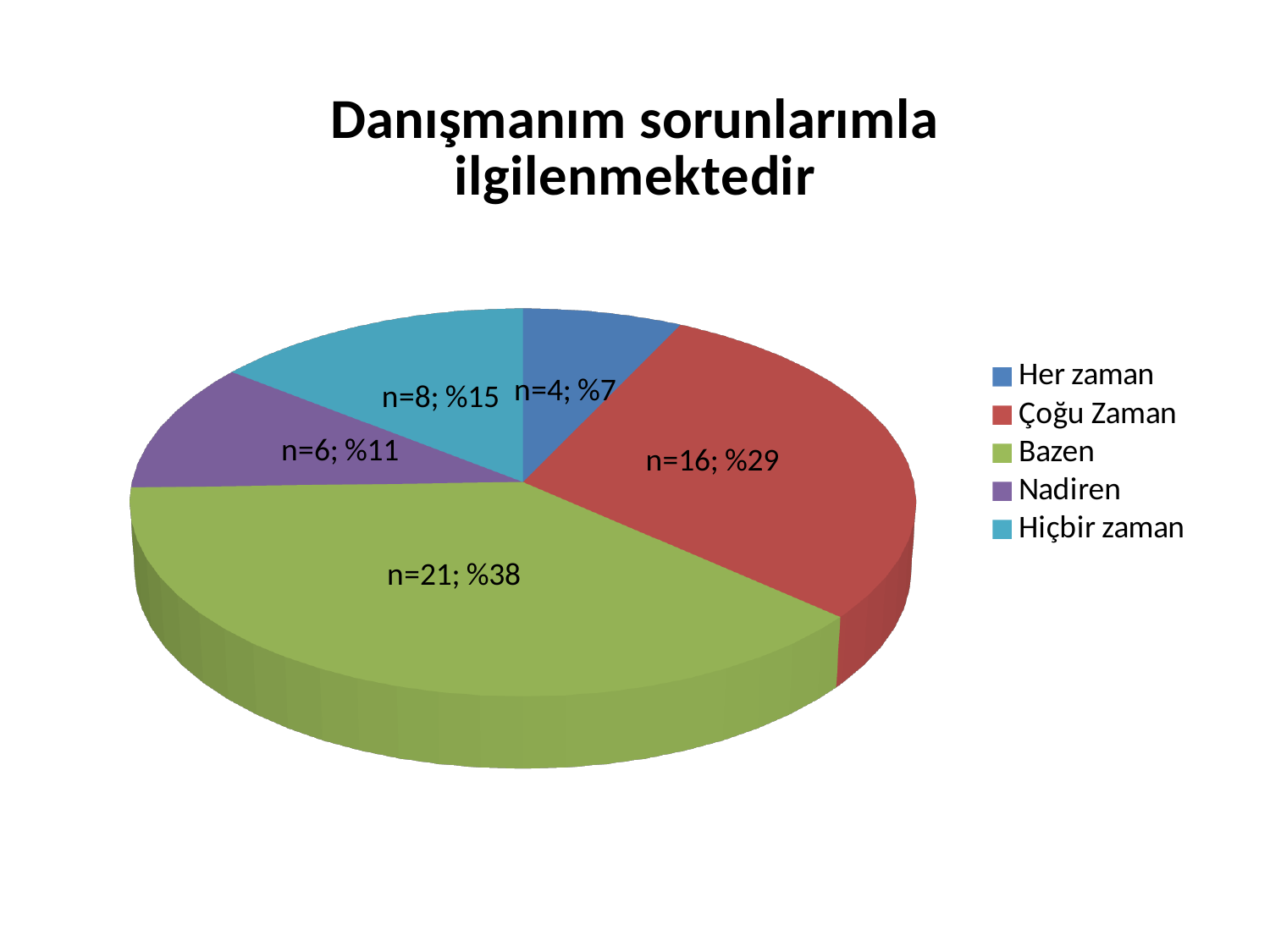
What kind of chart is shown on the slide? Pie chart What is the difference in n between Bazen and Çoğu Zaman? 5 What percentage share does the Çoğu Zaman slice have? %29 What percentage share does the Her zaman slice have? %7 How many slices does the pie chart have? 5 Which category has the smallest slice? Her zaman Which category has the largest slice? Bazen What is the title of the chart? Danışmanım sorunlarımla ilgilenmektedir What is the n value for the Hiçbir zaman slice? n=8 Which is larger, the Nadiren slice or the Hiçbir zaman slice? Hiçbir zaman What is the n value for the Bazen slice? n=21 Which colour represents Nadiren in the legend? Purple